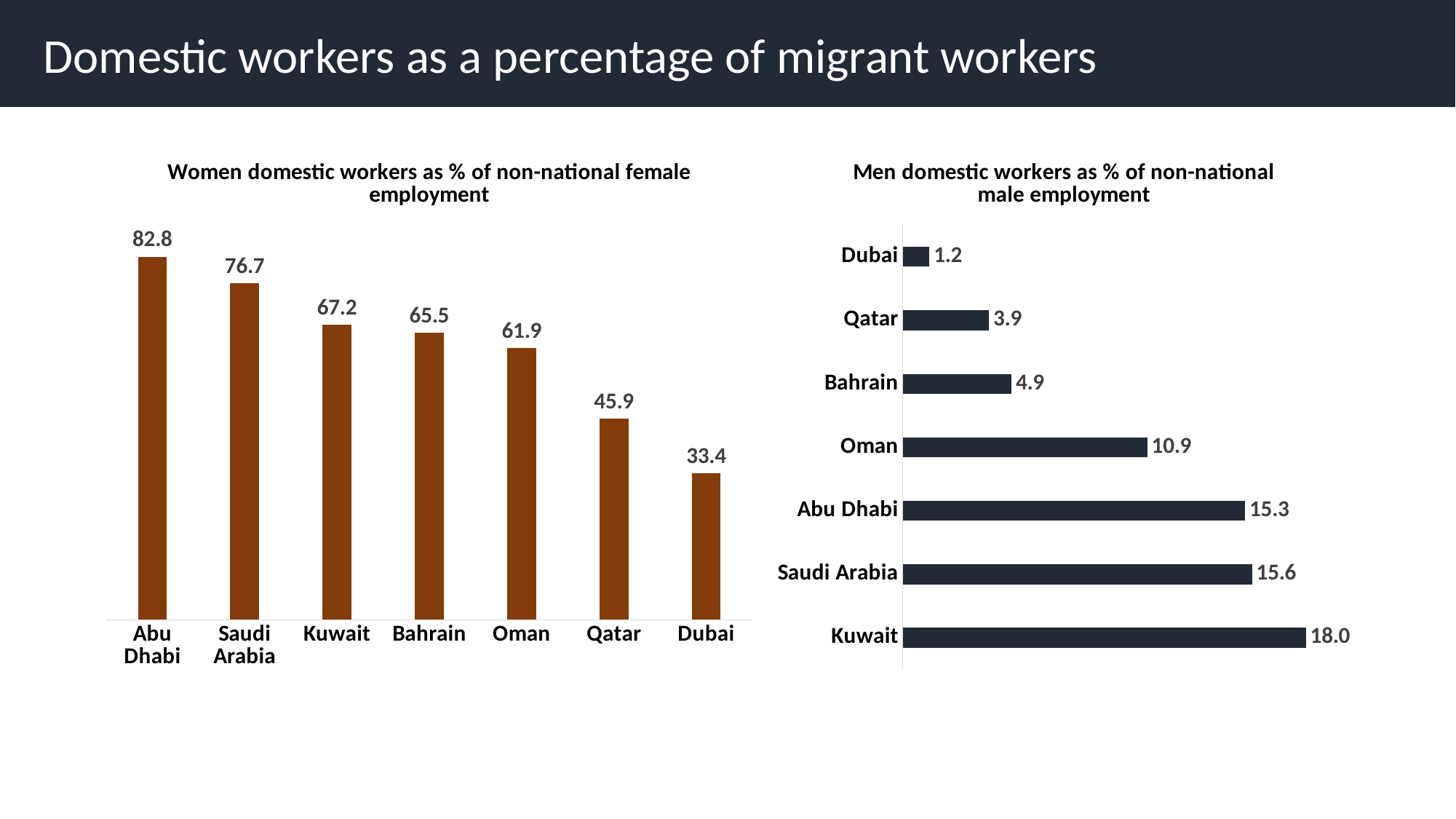
In the left chart (Women domestic workers), which is larger, the value for Bahrain or the value for Oman? Bahrain In the right chart (Men domestic workers), which category has the lowest value? Dubai In the left chart (Women domestic workers), do the values rise or fall from left to right along the x axis? Fall In the right chart (Men domestic workers), which category has the highest value? Kuwait In the left chart (Women domestic workers), what is the difference between the values for Abu Dhabi and Dubai? 49.4 How many categories are shown in the right chart (Men domestic workers)? 7 In the left chart (Women domestic workers), which category has the highest value? Abu Dhabi In the left chart (Women domestic workers as % of non-national female employment), what is the value for Kuwait? 67.2 In the right chart (Men domestic workers), what is the difference between the values for Kuwait and Qatar? 14.1 In the right chart (Men domestic workers as % of non-national male employment), what is the value for Oman? 10.9 How many categories are shown in the left chart (Women domestic workers)? 7 What kind of chart is the right chart (Men domestic workers)? Bar chart